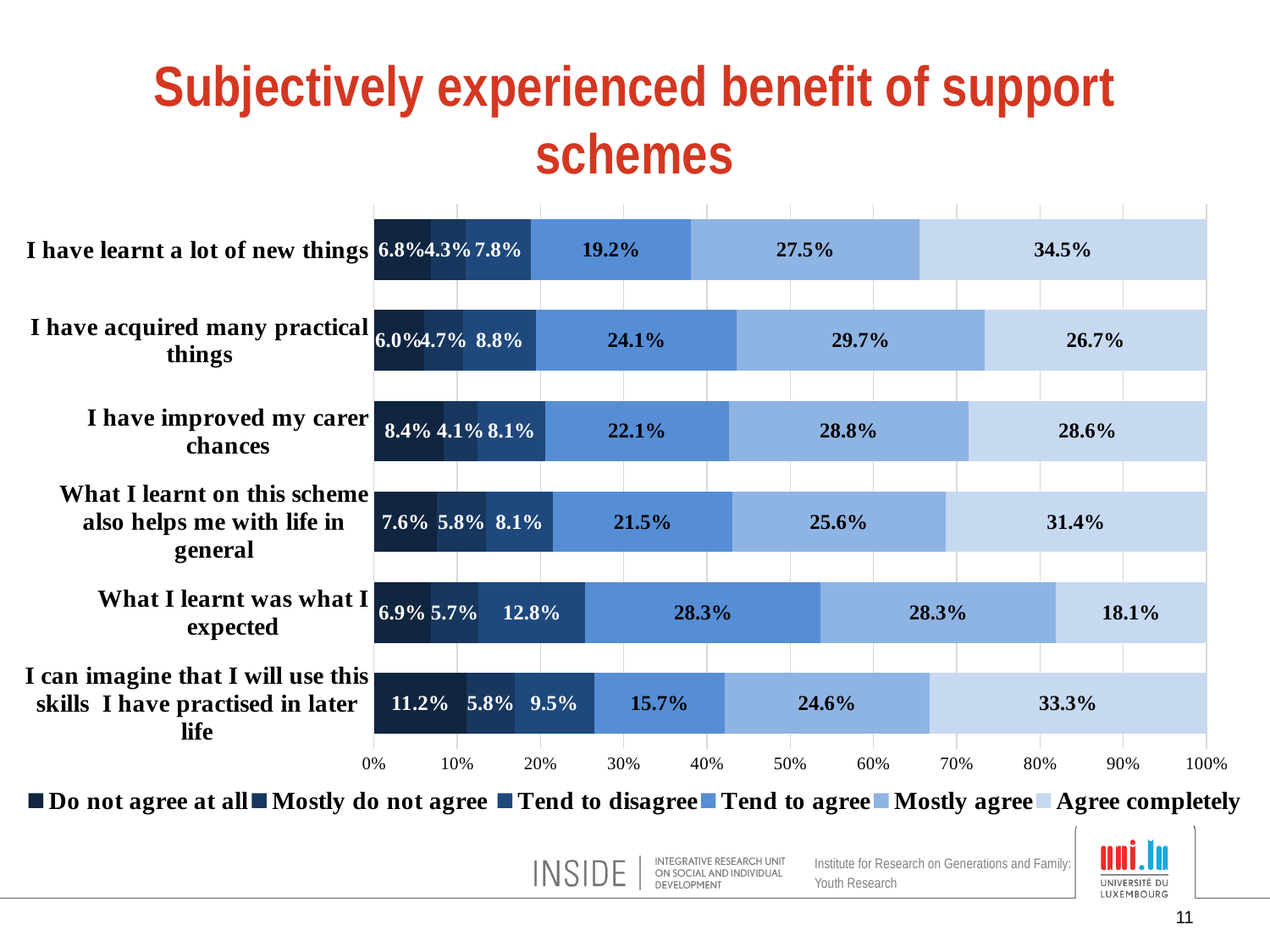
What kind of chart is shown on the slide? Stacked bar chart What percentage of respondents chose "Agree completely" for "I have learnt a lot of new things"? 34.5% Which statement has the highest "Agree completely" share? I have learnt a lot of new things What is the difference between the "Agree completely" values for "I have learnt a lot of new things" and "What I learnt was what I expected"? 16.4% What is the "Tend to agree" value for "What I learnt was what I expected"? 28.3% How many statements (categories) are shown in the chart? 6 Which statement has the lowest "Agree completely" share? What I learnt was what I expected What is the "Do not agree at all" value for "I can imagine that I will use this skills I have practised in later life"? 11.2% What is the "Mostly agree" value for "I have acquired many practical things"? 29.7% Which is larger: the "Tend to agree" value for "I have acquired many practical things" or for "I have learnt a lot of new things"? I have acquired many practical things Which statement has the highest "Do not agree at all" share? I can imagine that I will use this skills I have practised in later life How many series does the legend list? 6